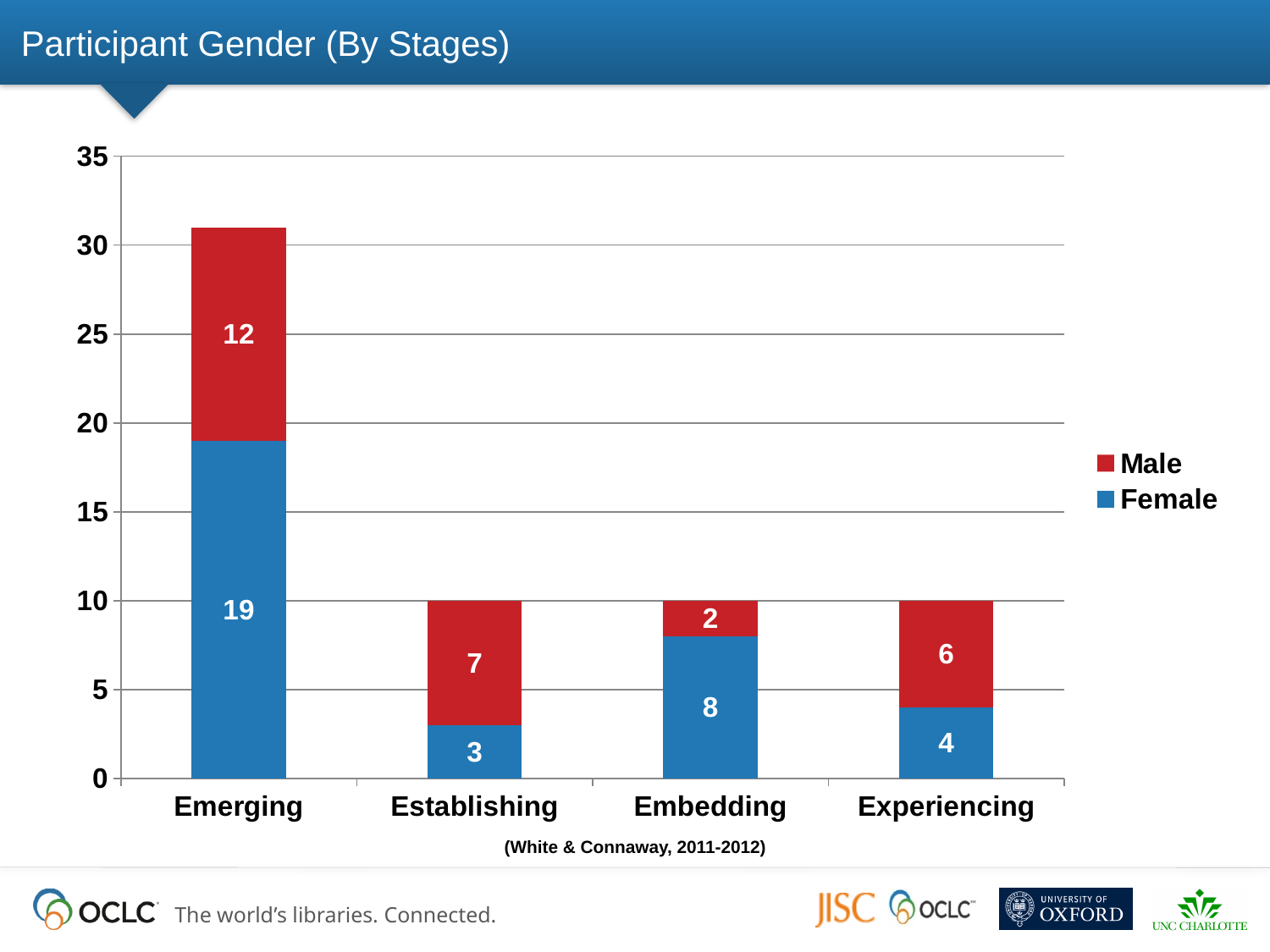
What kind of chart is shown on the slide? Stacked bar chart What is the difference between the Female and Male values for the Embedding stage? 6 How many series does the legend list? 2 What is the Male value for the Embedding stage? 2 What is the total of the stacked bar for the Emerging stage? 31 Which stage has the lowest Male value? Embedding Which is larger for the Establishing stage, the Male value or the Female value? Male Which stage has the highest Female value? Emerging What is the Male value for the Establishing stage? 7 What is the Female value for the Emerging stage? 19 How many stages are shown on the x axis? 4 What is the Female value for the Experiencing stage? 4